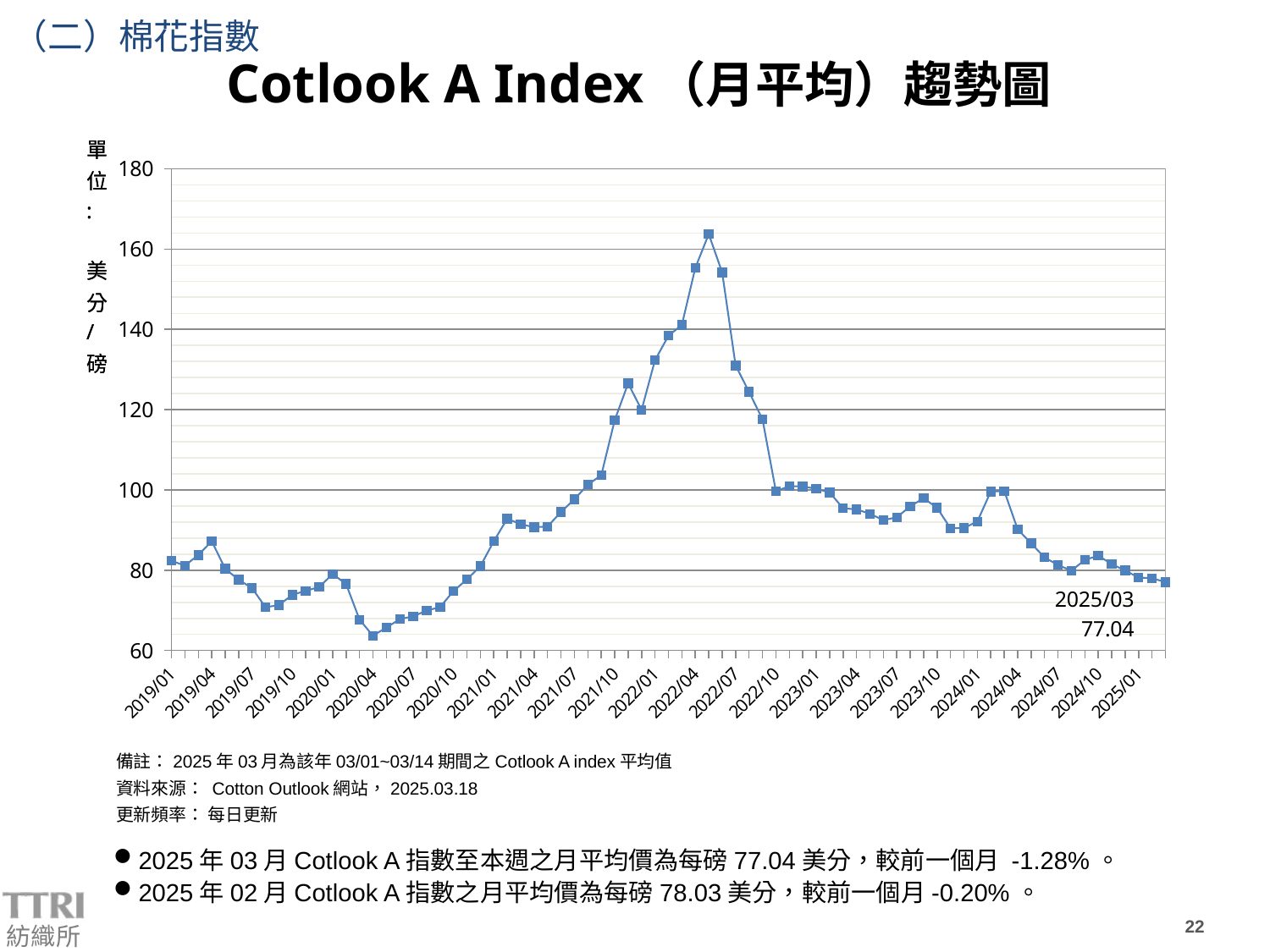
In which year does the Cotlook A Index reach its highest point on the chart? 2022 Is the value for 2020/04 greater or less than 80? less What is the value of the Cotlook A Index for 2025/03? 77.04 Is the value for 2023/01 greater or less than 120? less In which year does the Cotlook A Index reach its lowest point on the chart? 2020 Do the values rise or fall between 2022/04 and 2022/10? fall Which is larger, the value for 2022/04 or the value for 2023/04? 2022/04 What is the highest tick value shown on the y axis? 180 What kind of chart is shown on the slide? Line chart What unit is shown on the y axis of the chart? 美分/磅 Is the value for 2022/04 greater or less than 120? greater